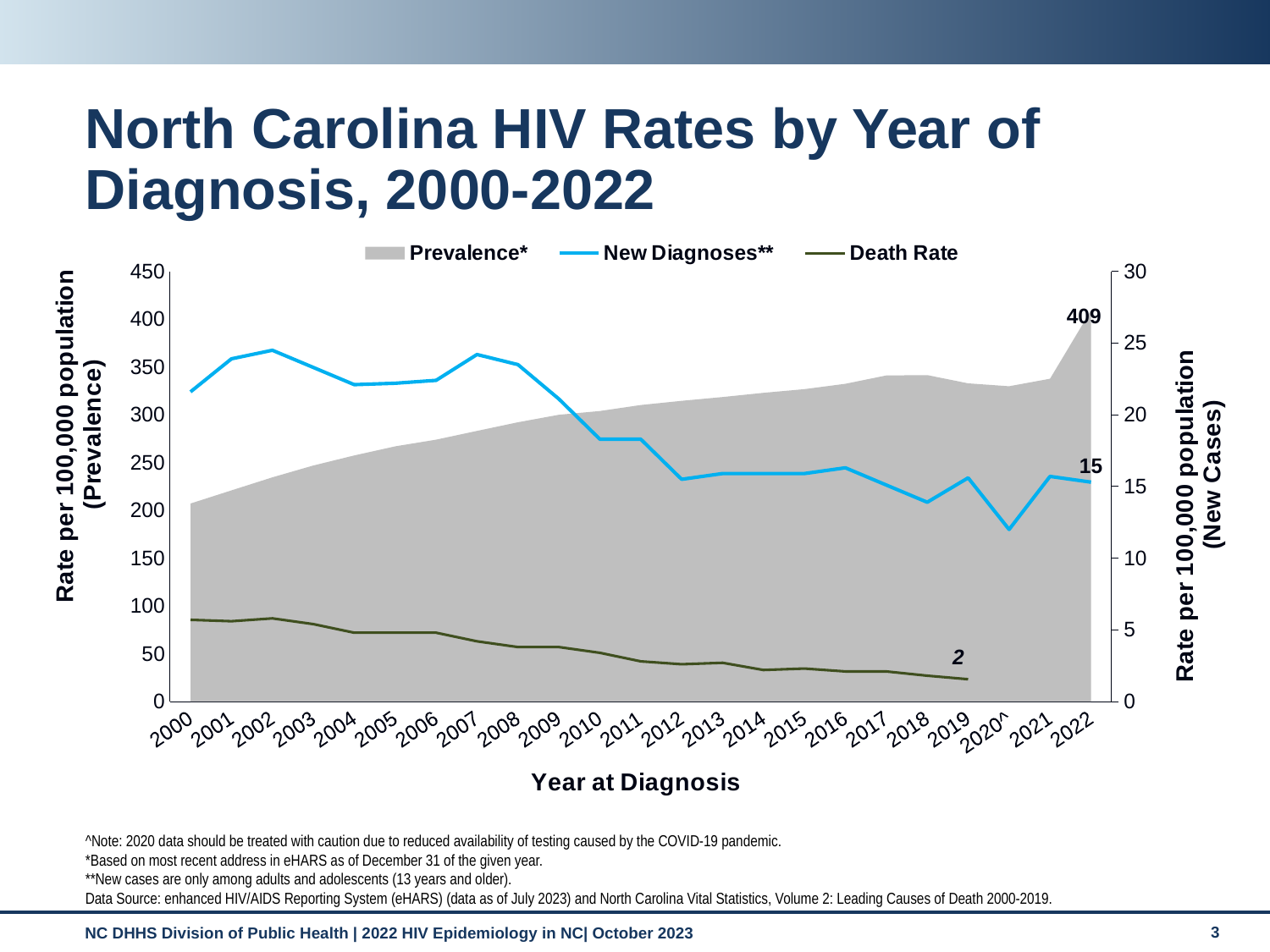
Which year has the larger New Diagnoses rate, 2002 or 2012? 2002 Does the Death Rate rise or fall from 2000 to 2019? fall Does the Prevalence rate generally rise or fall from 2000 to 2022? rise Is the Prevalence value for 2000 greater or less than 250 on the left axis? less How many series does the legend list? 3 In which year is the Prevalence rate highest? 2022 What is the Prevalence rate per 100,000 population in 2022? 409 What is the Death Rate value labelled in 2019? 2 What is the New Diagnoses rate per 100,000 population in 2022? 15 Is the New Diagnoses value for 2020^ greater or less than 15 on the right axis? less What is the title of the x axis? Year at Diagnosis How many years are shown along the x axis? 23